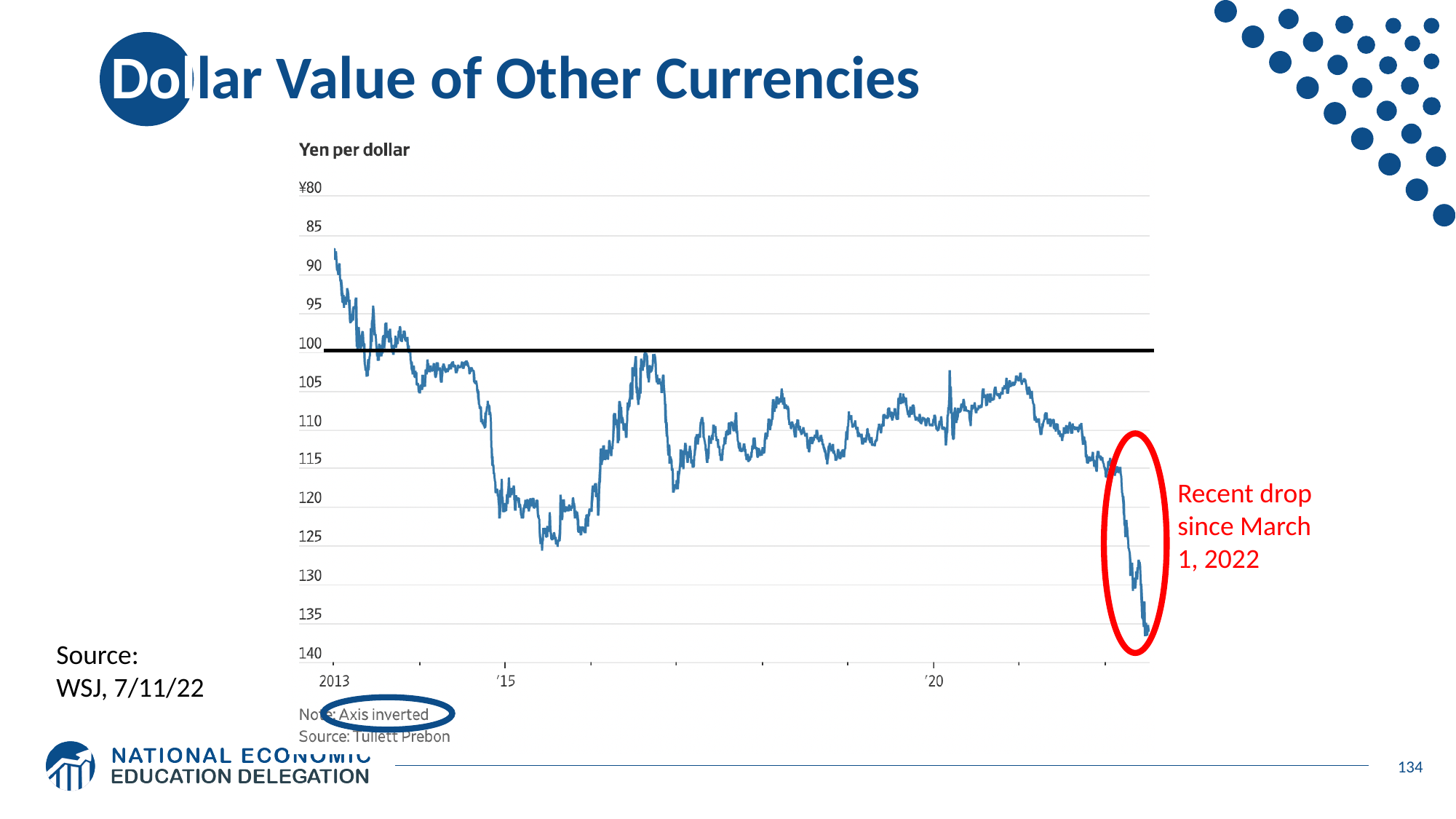
Which is numerically larger: the yen-per-dollar value at the start of 2013 or at the end of the series in 2022? 2022 What does the note beneath the chart say about the axis? Axis inverted Is the yen-per-dollar value at the '15 tick mark greater or less than 110? greater Is the yen-per-dollar value at the start of the series in 2013 greater or less than 100? less Is the yen-per-dollar value at the '20 tick mark greater or less than 100? greater Overall, from 2013 to 2022, does the yen-per-dollar value rise or fall? rise In which year does the line reach its numerically highest yen-per-dollar value? 2022 Which is numerically larger: the yen-per-dollar value at the '15 tick or at the '20 tick? '15 What quantity does the y-axis of the chart measure, according to its label? Yen per dollar What kind of chart is shown on the slide? line chart How many data series are plotted on the chart? 1